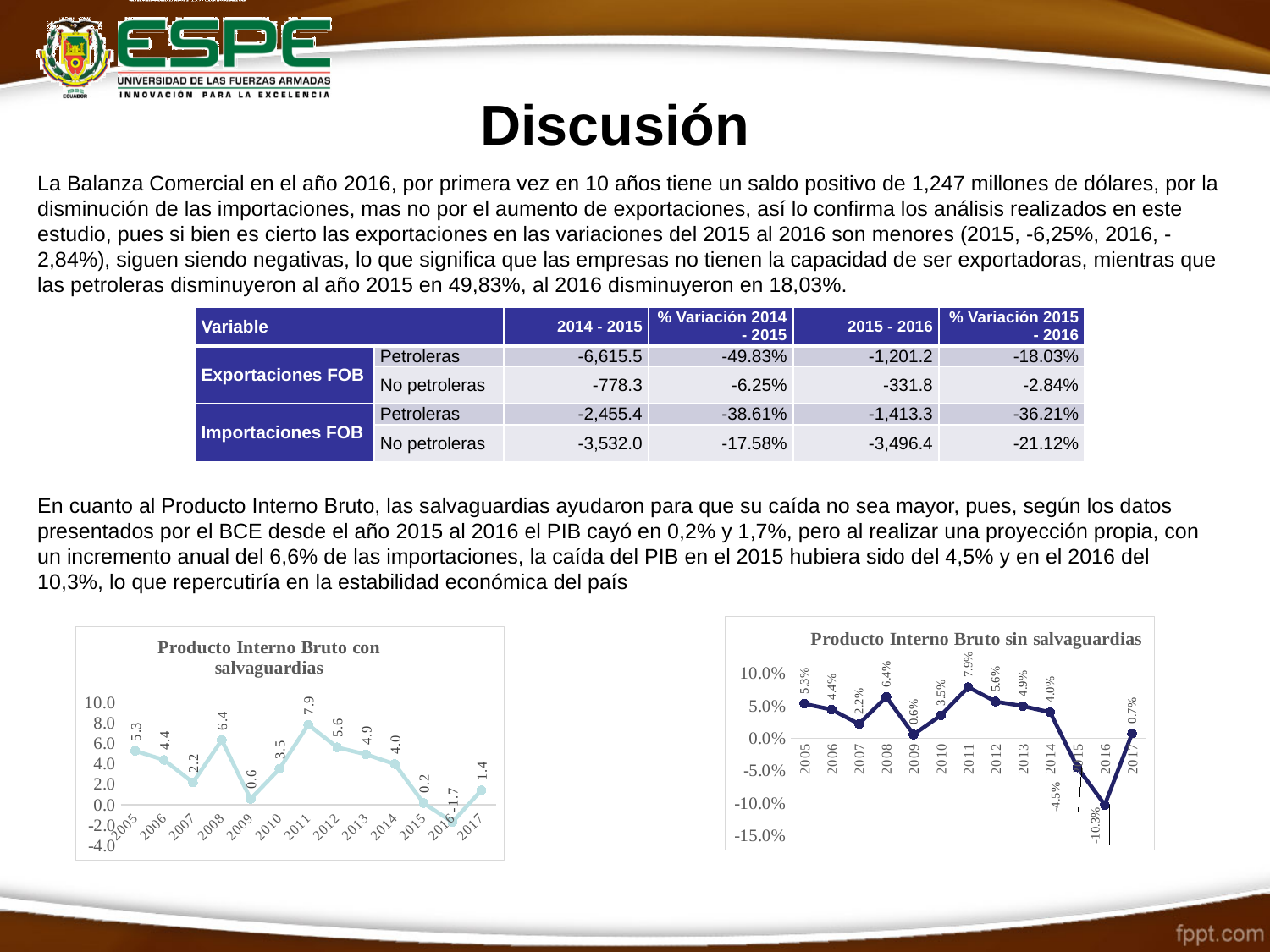
How many years are plotted in the chart 'Producto Interno Bruto sin salvaguardias'? 13 In the chart 'Producto Interno Bruto sin salvaguardias', do the values rise or fall from 2014 to 2016? Fall In the chart 'Producto Interno Bruto sin salvaguardias', what is the value for 2016? -10.3% In the chart 'Producto Interno Bruto sin salvaguardias', which year has the lowest value? 2016 In the chart 'Producto Interno Bruto con salvaguardias', what is the value for 2016? -1.7 In the chart 'Producto Interno Bruto sin salvaguardias', what is the value for 2015? -4.5% In the chart 'Producto Interno Bruto sin salvaguardias', is the value for 2012 larger or the value for 2013? 2012 What kind of chart is 'Producto Interno Bruto con salvaguardias'? Line chart In the chart 'Producto Interno Bruto con salvaguardias', what is the value for 2011? 7.9 In the chart 'Producto Interno Bruto con salvaguardias', what is the difference between the values for 2008 and 2009? 5.8 In the chart 'Producto Interno Bruto con salvaguardias', which year has the highest value? 2011 In the chart 'Producto Interno Bruto con salvaguardias', which year has the lowest value? 2016